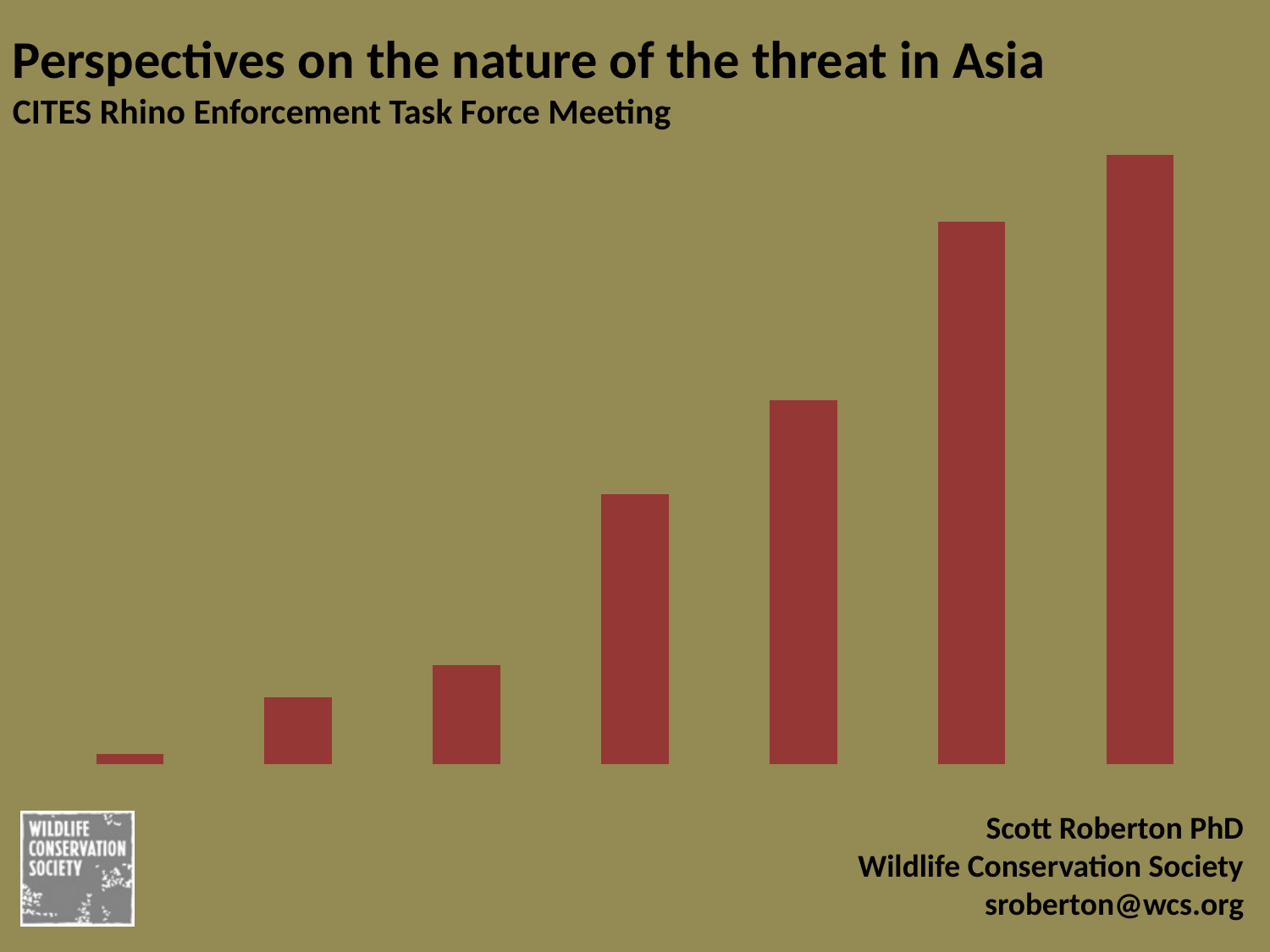
Do the bar values rise or fall from left to right across the chart? rise Which bar is the shortest in the chart? the leftmost bar Which bar is the tallest in the chart? the rightmost bar What kind of chart is shown on the slide? bar chart Is the leftmost bar taller or shorter than the second bar from the left? shorter What colour are the bars in the chart? dark red How many bars does the chart contain? 7 Which is taller, the fourth bar from the left or the third bar from the left? the fourth bar from the left Which is taller, the second bar from the right or the rightmost bar? the rightmost bar Does the chart display any axis labels or data labels? No